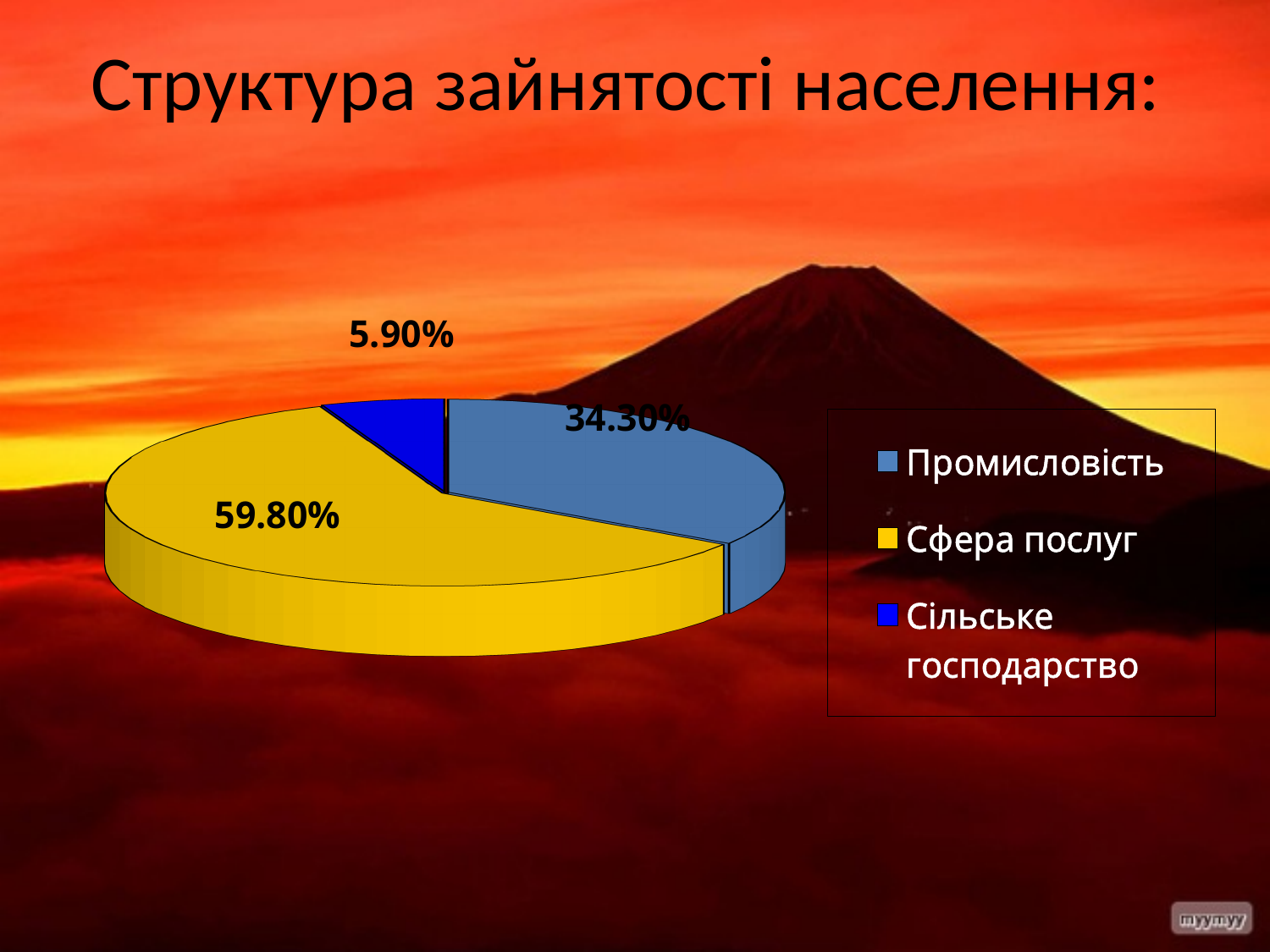
What share of employment does Сфера послуг account for? 59.80% Which sector has the smallest share of employment? Сільське господарство What colour is the slice for Сфера послуг? yellow What is the difference in percentage points between Промисловість and Сільське господарство? 28.40 What is the difference in percentage points between Сфера послуг and Промисловість? 25.50 What is the title of the slide? Структура зайнятості населення: Which sector has the largest share of employment? Сфера послуг What share of employment does Сільське господарство account for? 5.90% How many sectors are shown in the pie chart? 3 What share of employment does Промисловість account for? 34.30% What kind of chart is shown on the slide? pie chart Which is larger, the share for Промисловість or the share for Сільське господарство? Промисловість